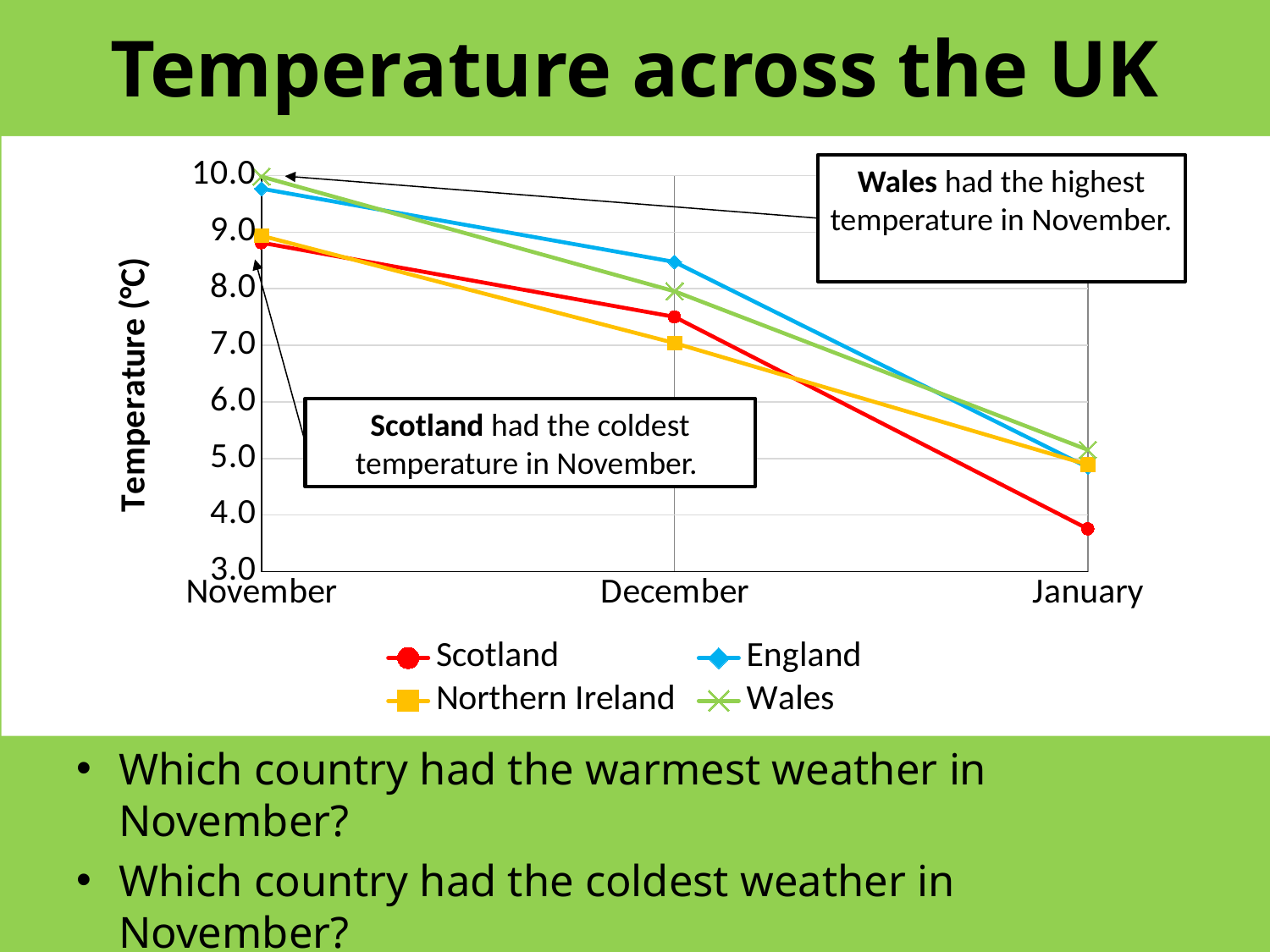
What is the label on the y axis? Temperature (°C) How many series does the legend list? 4 Which country had the highest temperature in December? England Is the temperature for Scotland in January greater or less than 4.0? less How many months are shown on the x axis? 3 Which country had the highest temperature in November? Wales Is the temperature for England in December greater or less than 8.0? greater What kind of chart is shown on the slide? Line chart Do the temperatures for Scotland rise or fall from November to January? Fall Which country had the lowest temperature in January? Scotland In January, which is higher: the temperature for England or for Scotland? England Which country had the lowest temperature in November? Scotland